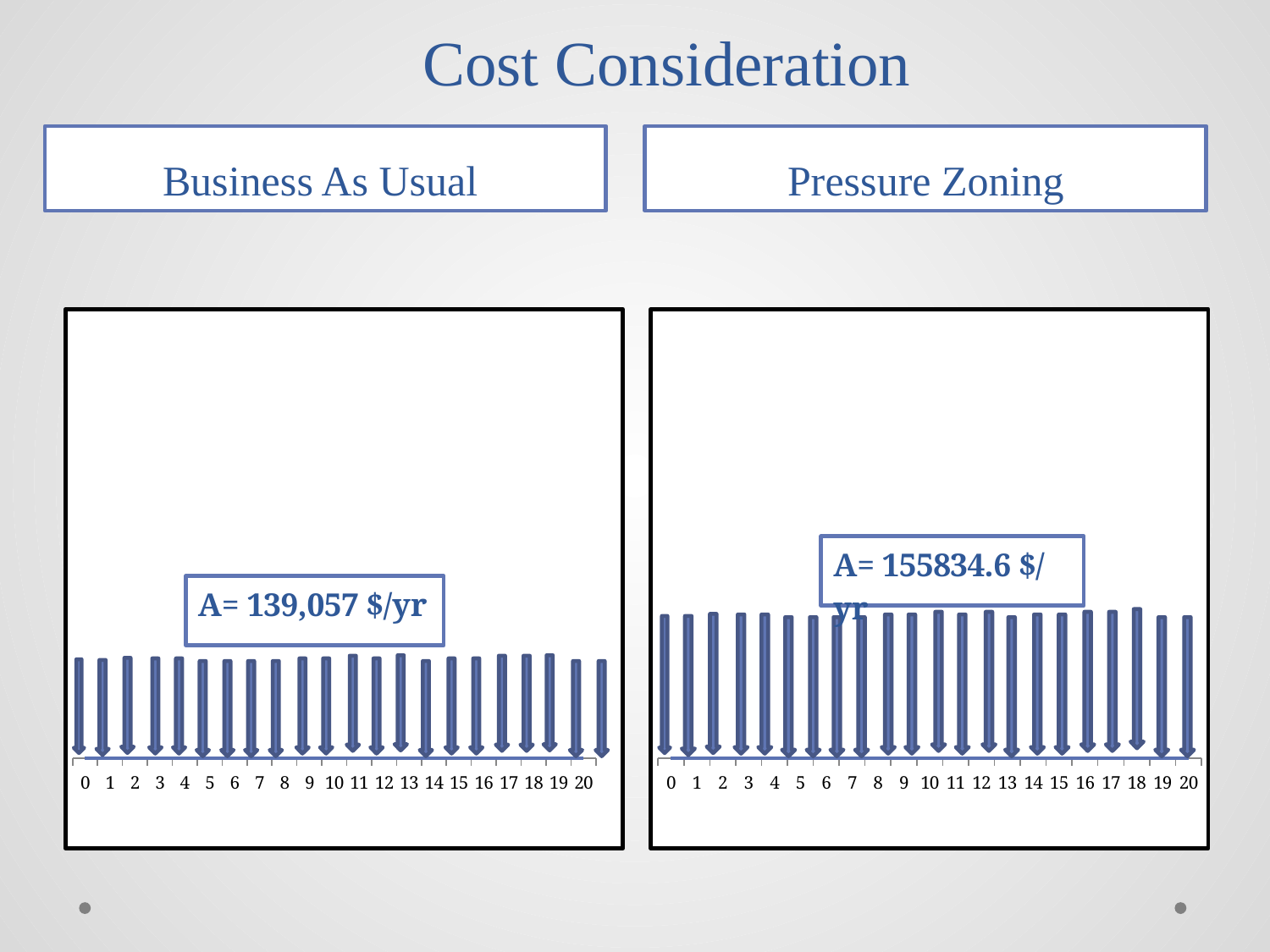
What is the last x-axis label on the Business As Usual chart? 20 What annual value A is printed on the Pressure Zoning chart? 155834.6 $/yr What colour are the bars in the Pressure Zoning chart? blue What is the title of the slide containing the two charts? Cost Consideration Which chart shows the larger annual value A, Business As Usual or Pressure Zoning? Pressure Zoning How many categories are shown on the x axis of the Business As Usual chart? 21 What kind of chart is the Business As Usual chart? bar chart On the Business As Usual chart, do the bars rise, fall, or stay roughly the same from year 0 to year 20? stay roughly the same What is the difference between the annual value A on the Pressure Zoning chart and the annual value A on the Business As Usual chart? 16777.6 $/yr What annual value A is printed on the Business As Usual chart? 139,057 $/yr How many categories are shown on the x axis of the Pressure Zoning chart? 21 What is the first x-axis label on the Pressure Zoning chart? 0